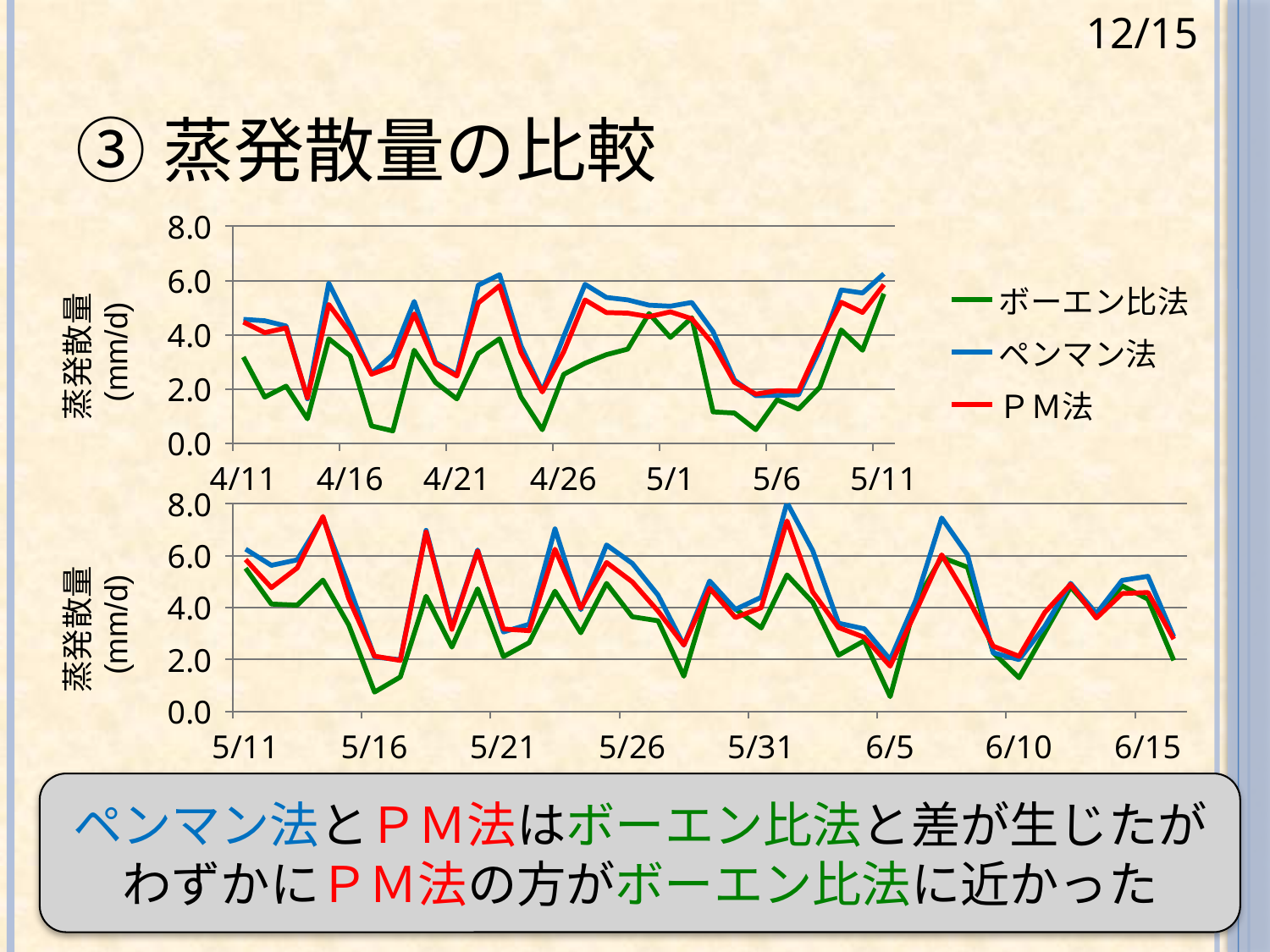
In the bottom chart, is the value for ボーエン比法 at 5/16 greater or less than 2.0? less What kind of chart is the bottom chart on the slide? line chart In the bottom chart, is the value for ＰＭ法 at 5/14 greater or less than 6.0? greater What kind of chart is the top chart on the slide? line chart In the bottom chart, is the value for ペンマン法 at 6/1 greater or less than 6.0? greater Which series is drawn in green in the legend? ボーエン比法 In the top chart, which is larger at 4/18: ペンマン法 or ボーエン比法? ペンマン法 What is the label of the y axis on the top chart? 蒸発散量 (mm/d) In the bottom chart, which is larger at 6/5: ＰＭ法 or ボーエン比法? ＰＭ法 How many series does the legend list? 3